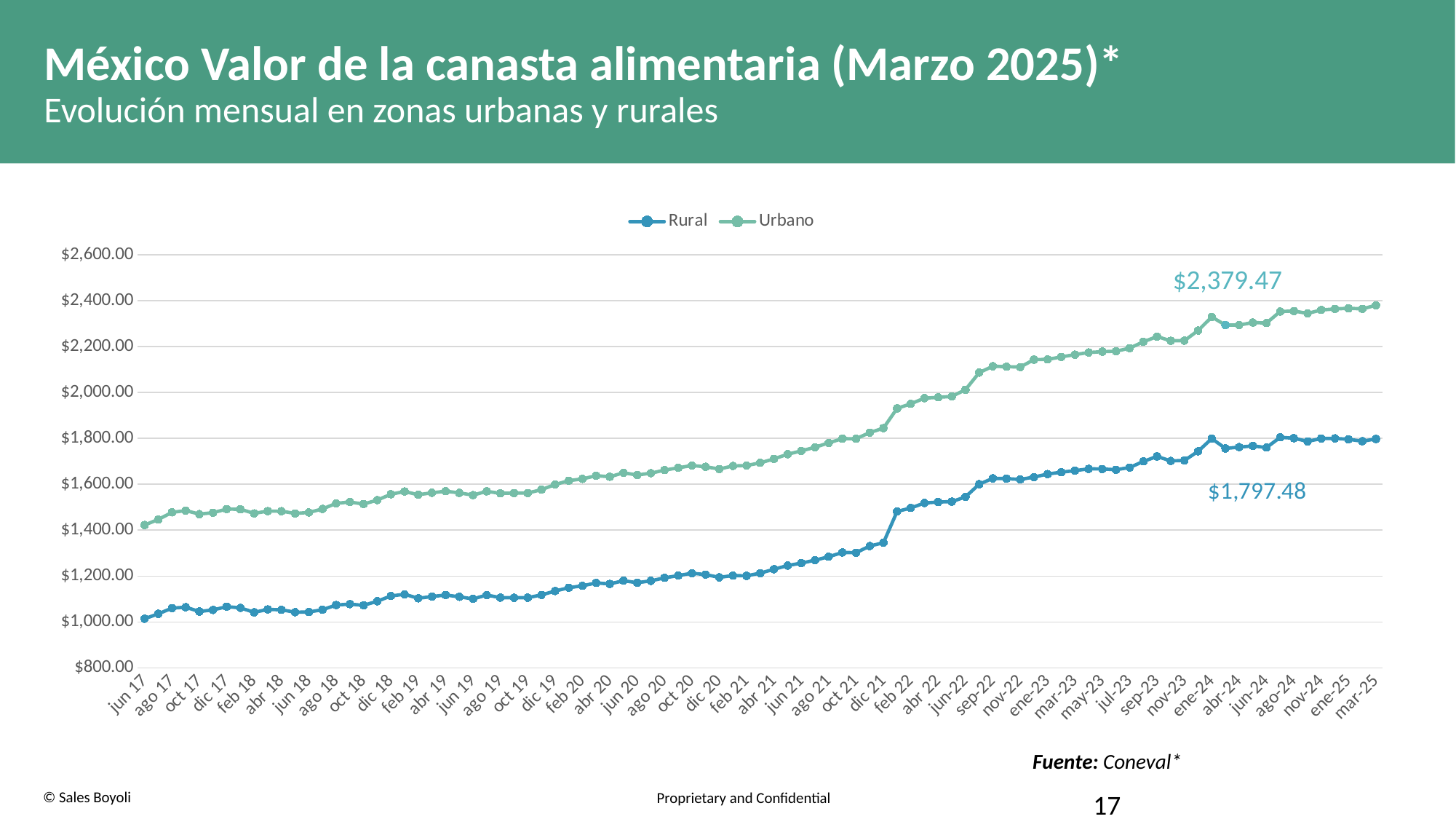
What is the value of the Urbano series at mar-25? $2,379.47 How many series does the legend list? 2 What are the two series named in the legend? Rural and Urbano What kind of chart is shown on the slide? line chart Is the value for Urbano at feb 22 greater or less than $1,800.00? greater Do the values of the Rural series generally rise or fall from jun 17 to mar-25? rise What is the value of the Rural series at mar-25? $1,797.48 What is the difference between the Urbano and Rural values at mar-25? $581.99 Is the value for Rural at jun 17 greater or less than $1,200.00? less Is the value for Rural at dic 21 greater or less than $1,400.00? less Which series has the higher value at mar-25, Rural or Urbano? Urbano